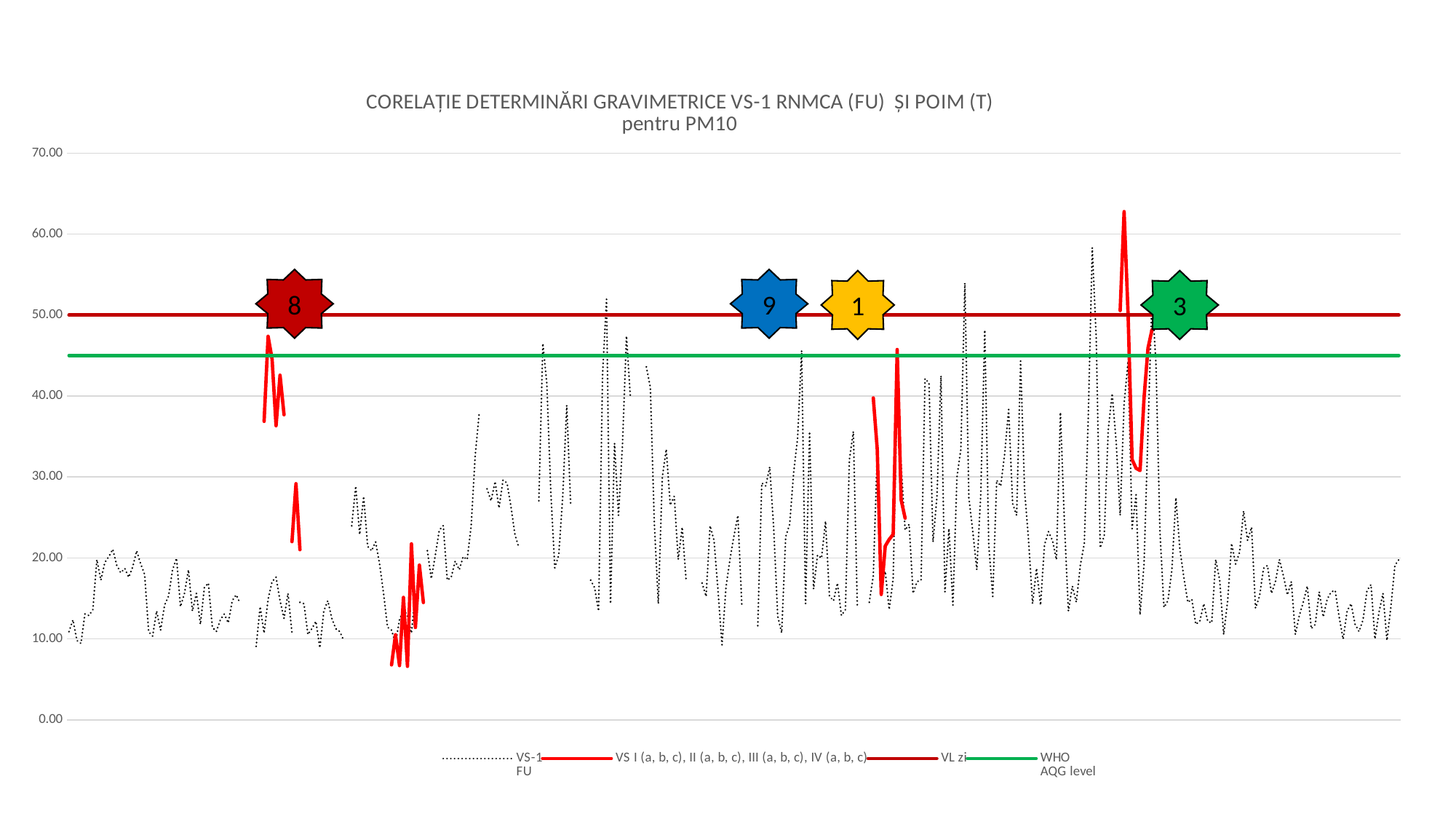
What value does the VL zi line sit at on the y axis? 50.00 Is the highest peak of the dotted VS-1 FU series greater or less than 60? less Is the highest peak of the red VS I (a, b, c), II (a, b, c), III (a, b, c), IV (a, b, c) series greater or less than 50? greater Is the WHO AQG level line greater or less than 50? less Which is higher on the chart, the VL zi line or the WHO AQG level line? VL zi What is the title of the chart? CORELAȚIE DETERMINĂRI GRAVIMETRICE VS-1 RNMCA (FU) ȘI POIM (T) pentru PM10 How many series does the legend list? 4 What is the maximum value shown on the y axis? 70.00 Which series is drawn as a dotted line? VS-1 FU What kind of chart is shown on the slide? line chart